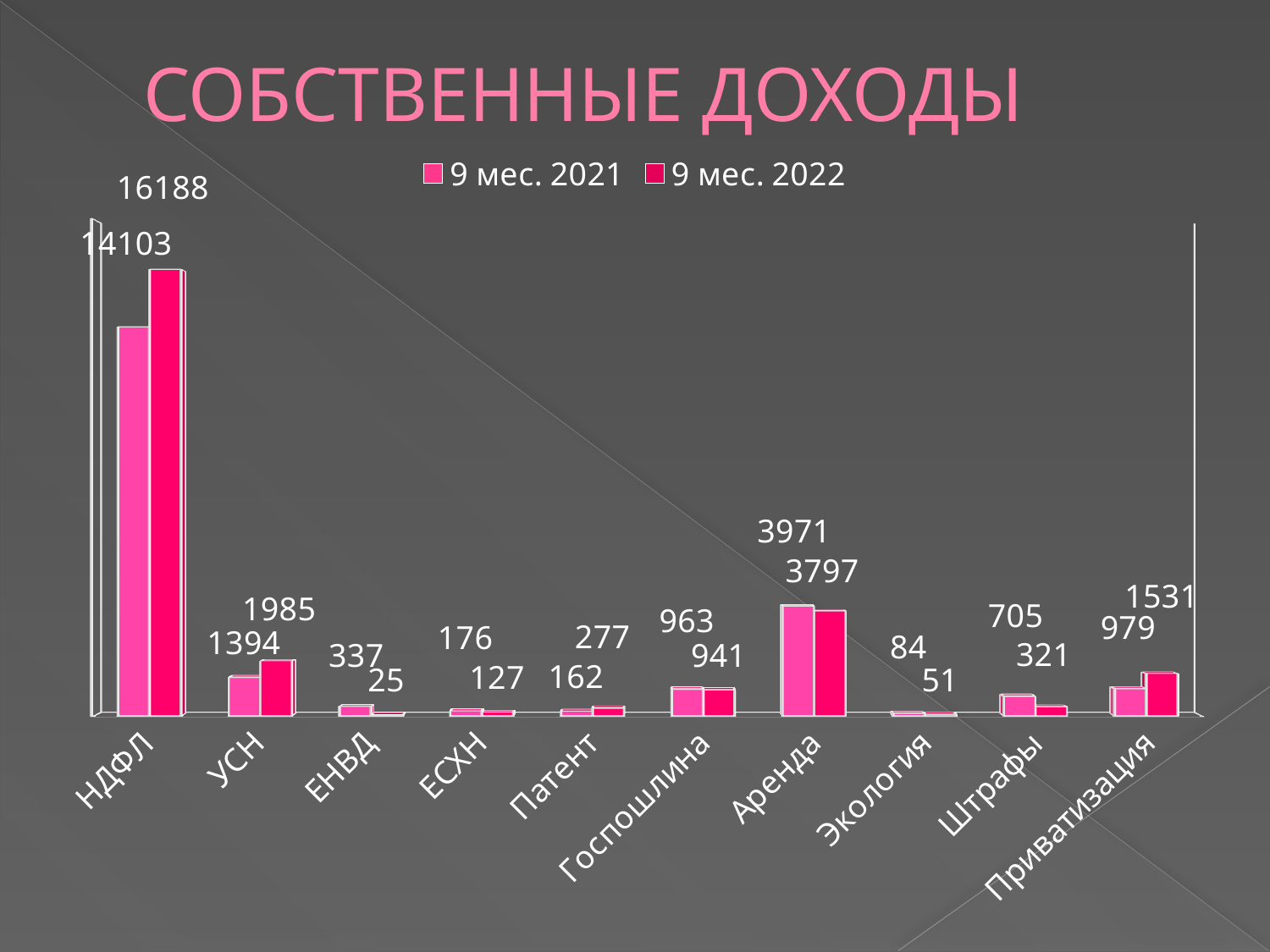
What is the difference between the 9 мес. 2022 and 9 мес. 2021 values for НДФЛ? 2085 Which category has the highest value in the 9 мес. 2021 series? НДФЛ Which is larger for Экология: the 9 мес. 2021 value or the 9 мес. 2022 value? 9 мес. 2021 What is the value for НДФЛ in the 9 мес. 2022 series? 16188 How many series does the legend list? 2 Which is larger for Приватизация: the 9 мес. 2021 value or the 9 мес. 2022 value? 9 мес. 2022 How many categories are shown on the x axis? 10 What is the value for ЕНВД in the 9 мес. 2022 series? 25 What is the difference between the 9 мес. 2021 and 9 мес. 2022 values for Штрафы? 384 What is the value for Аренда in the 9 мес. 2021 series? 3971 Which category has the lowest value in the 9 мес. 2022 series? ЕНВД What kind of chart is shown on the slide? Bar chart